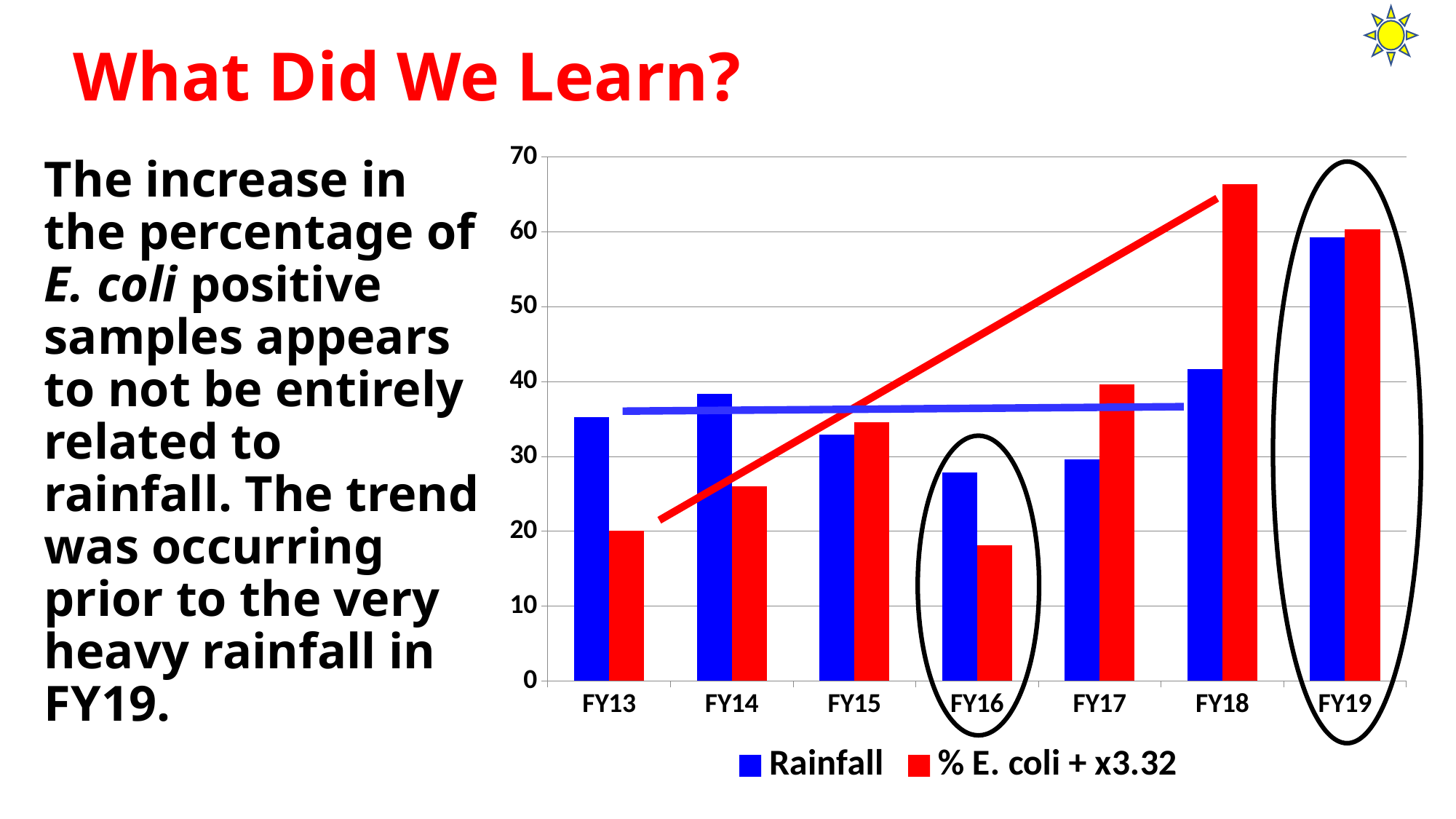
Is the Rainfall value for FY19 greater or less than 50? greater How many fiscal years are shown on the x axis of the chart? 7 What colour are the Rainfall bars in the chart? blue Which fiscal year has the highest Rainfall value? FY19 In FY18, which is larger: Rainfall or % E. coli + x3.32? % E. coli + x3.32 In FY13, which is larger: Rainfall or % E. coli + x3.32? Rainfall Is the % E. coli + x3.32 value for FY18 greater or less than 60? greater What kind of chart is shown on the slide? bar chart Which fiscal year has the lowest value for % E. coli + x3.32? FY16 Which fiscal year has the highest value for % E. coli + x3.32? FY18 How many series does the chart legend list? 2 Is the % E. coli + x3.32 value for FY16 greater or less than 20? less